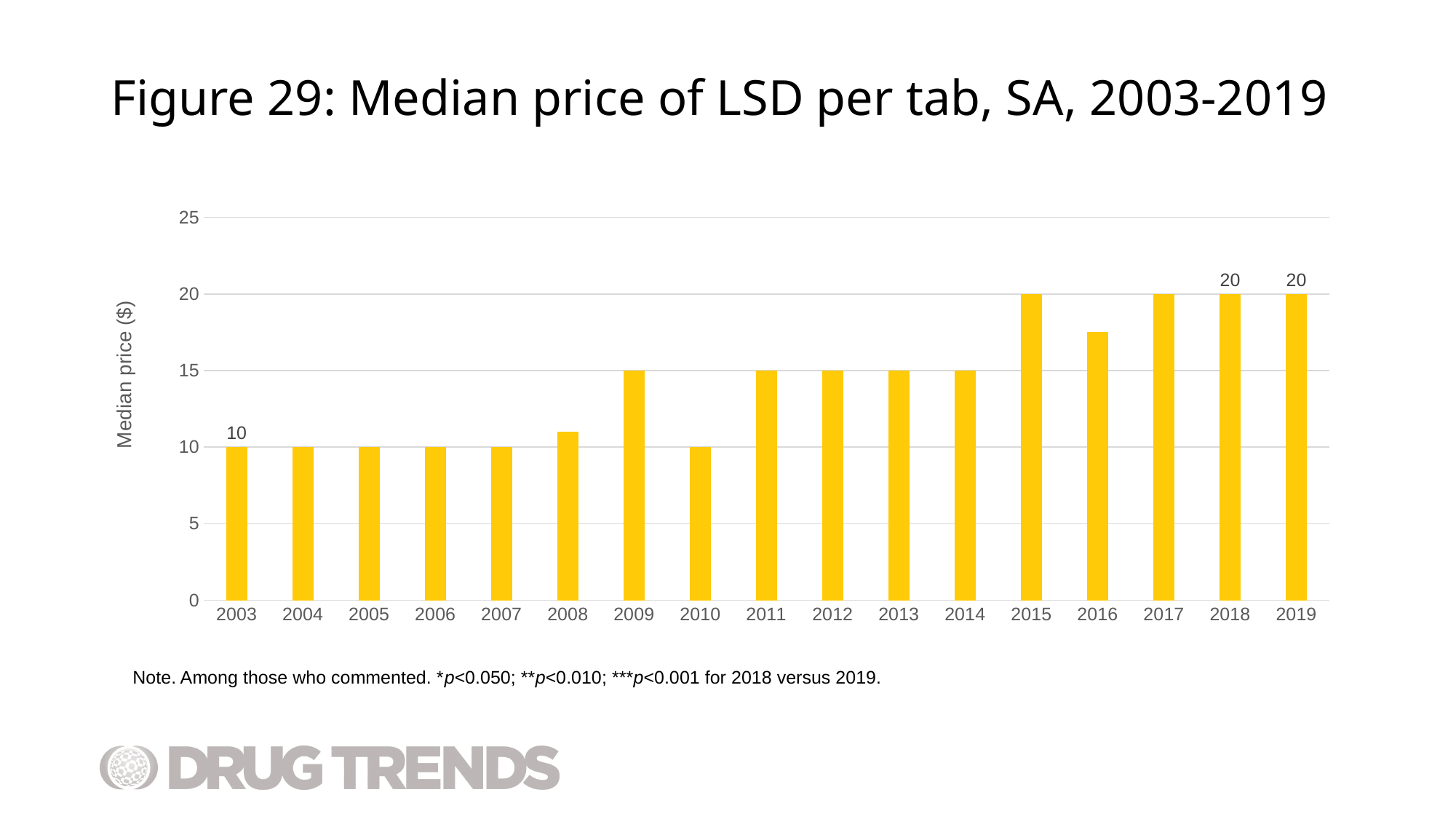
Which year has the larger median price, 2010 or 2015? 2015 What is the median price of LSD per tab in 2018? 20 Is the value for 2012 greater or less than 10? greater How many years are shown on the x axis of the chart? 17 What is the label on the y axis of the chart? Median price ($) Is the value for 2008 greater or less than 15? less Overall, does the median price of LSD per tab rise or fall from 2003 to 2019? rise What is the median price of LSD per tab in 2003? 10 What kind of chart is shown on the slide? bar chart Is the value for 2016 greater or less than 15? greater What is the difference between the median price in 2019 and the median price in 2003? 10 What is the median price of LSD per tab in 2019? 20